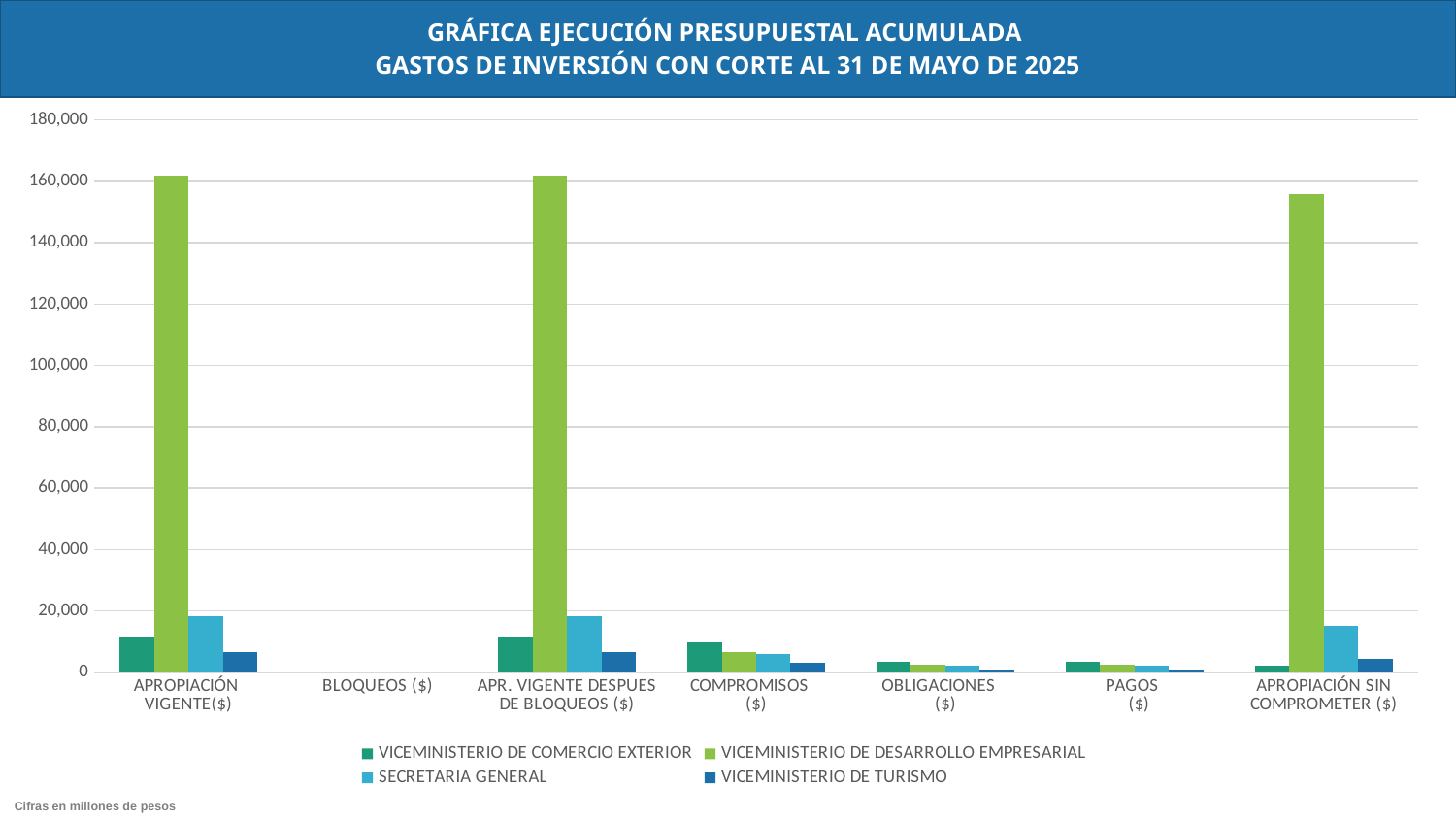
In the APROPIACIÓN VIGENTE($) category, which is larger: SECRETARIA GENERAL or VICEMINISTERIO DE COMERCIO EXTERIOR? SECRETARIA GENERAL Which category shows the lowest values for all series? BLOQUEOS ($) Is the value for VICEMINISTERIO DE DESARROLLO EMPRESARIAL in APROPIACIÓN VIGENTE($) greater or less than 140,000? greater What kind of chart is shown on the slide? Bar chart Which series has the highest value in the APROPIACIÓN VIGENTE($) category? VICEMINISTERIO DE DESARROLLO EMPRESARIAL According to the note at the bottom of the slide, in what units are the figures expressed? Millones de pesos How many categories are shown along the x axis? 7 In the COMPROMISOS ($) category, which is larger: VICEMINISTERIO DE COMERCIO EXTERIOR or VICEMINISTERIO DE DESARROLLO EMPRESARIAL? VICEMINISTERIO DE COMERCIO EXTERIOR How many series does the legend list? 4 Is the value for VICEMINISTERIO DE DESARROLLO EMPRESARIAL in APROPIACIÓN SIN COMPROMETER ($) greater or less than 160,000? less Which series has the lowest value in the APROPIACIÓN VIGENTE($) category? VICEMINISTERIO DE TURISMO